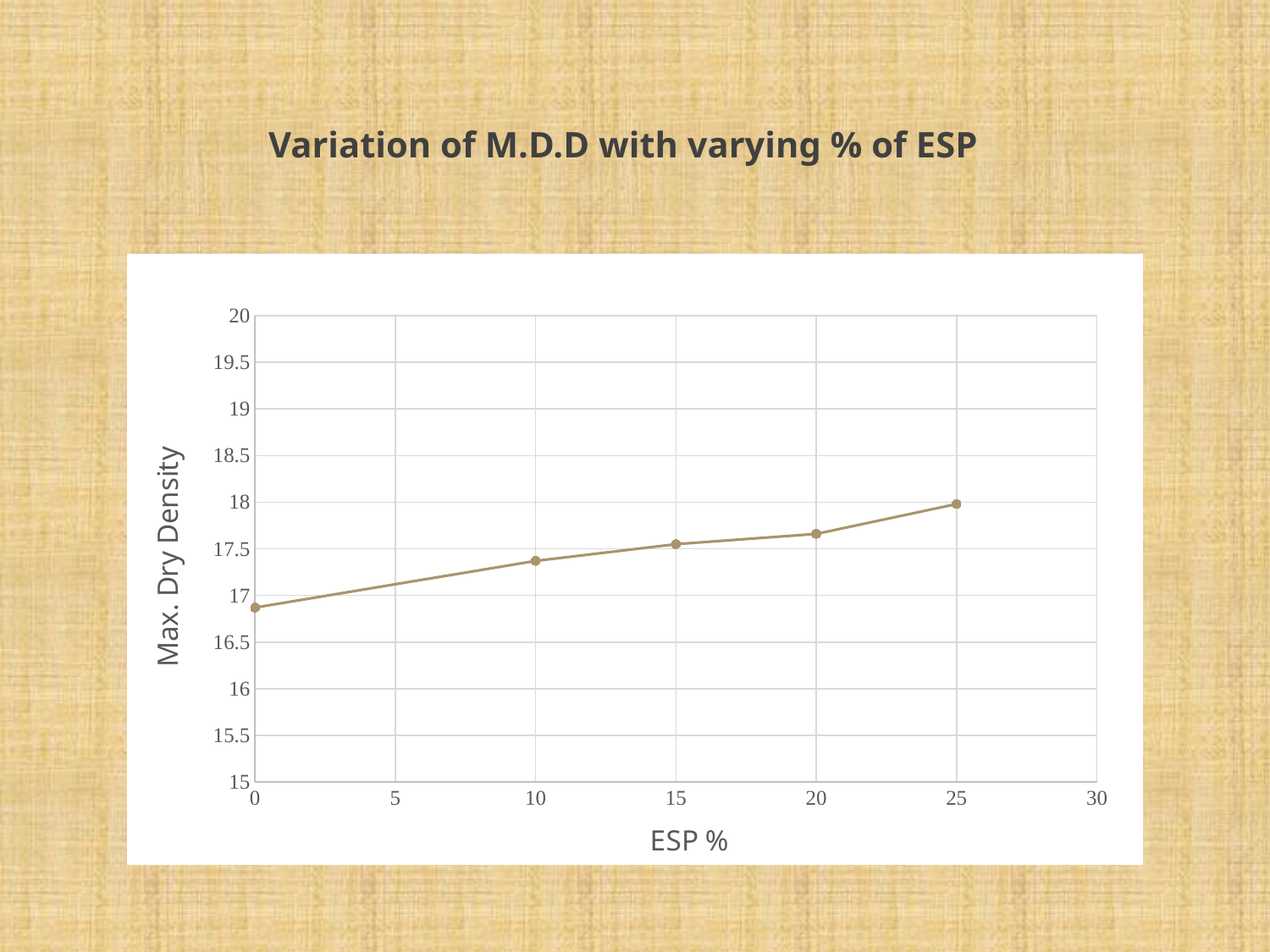
What is the title of the chart? Variation of M.D.D with varying % of ESP Which has the larger Max. Dry Density, 0% ESP or 25% ESP? 25% ESP What kind of chart is shown on the slide? Line chart Does Max. Dry Density rise or fall as ESP % increases? Rises Is the Max. Dry Density at 25% ESP greater or less than 17.5? greater Is the Max. Dry Density at 10% ESP greater or less than 17? greater At which ESP % is the Max. Dry Density lowest? 0 Is the Max. Dry Density at 20% ESP greater or less than 17.5? greater At which ESP % is the Max. Dry Density highest? 25 What is the label of the y axis? Max. Dry Density How many data points are plotted on the line? 5